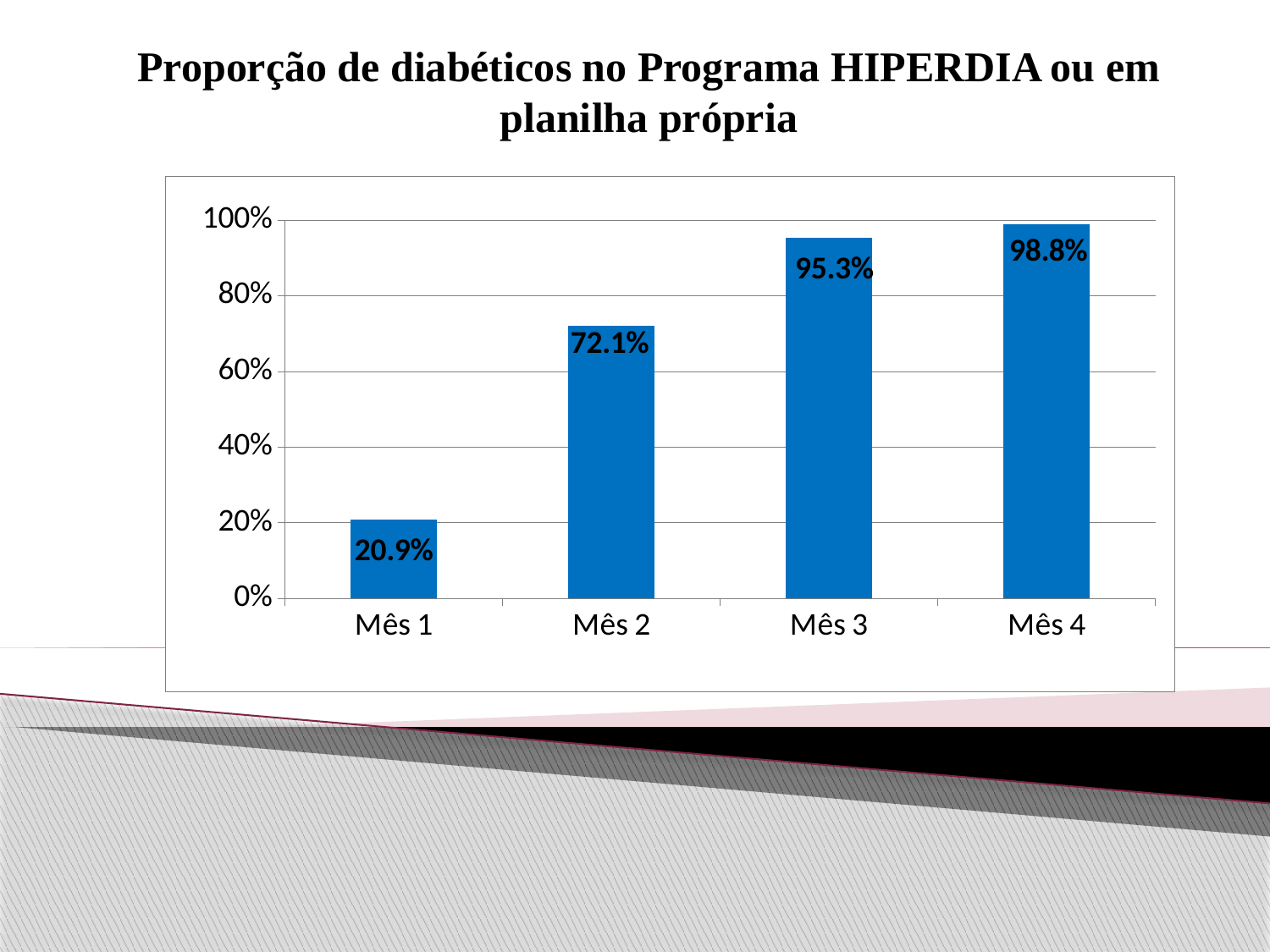
What is the value for Mês 1? 20.9% What is the value for Mês 3? 95.3% What kind of chart is shown on the slide? bar chart What is the value for Mês 4? 98.8% What is the value for Mês 2? 72.1% Which is larger, the value for Mês 2 or the value for Mês 3? Mês 3 How many months are shown on the x axis? 4 What is the difference between the values for Mês 2 and Mês 1? 51.2% Which month has the lowest value? Mês 1 Which month has the highest value? Mês 4 Is the value for Mês 2 greater or less than 60%? greater What is the difference between the values for Mês 4 and Mês 3? 3.5%